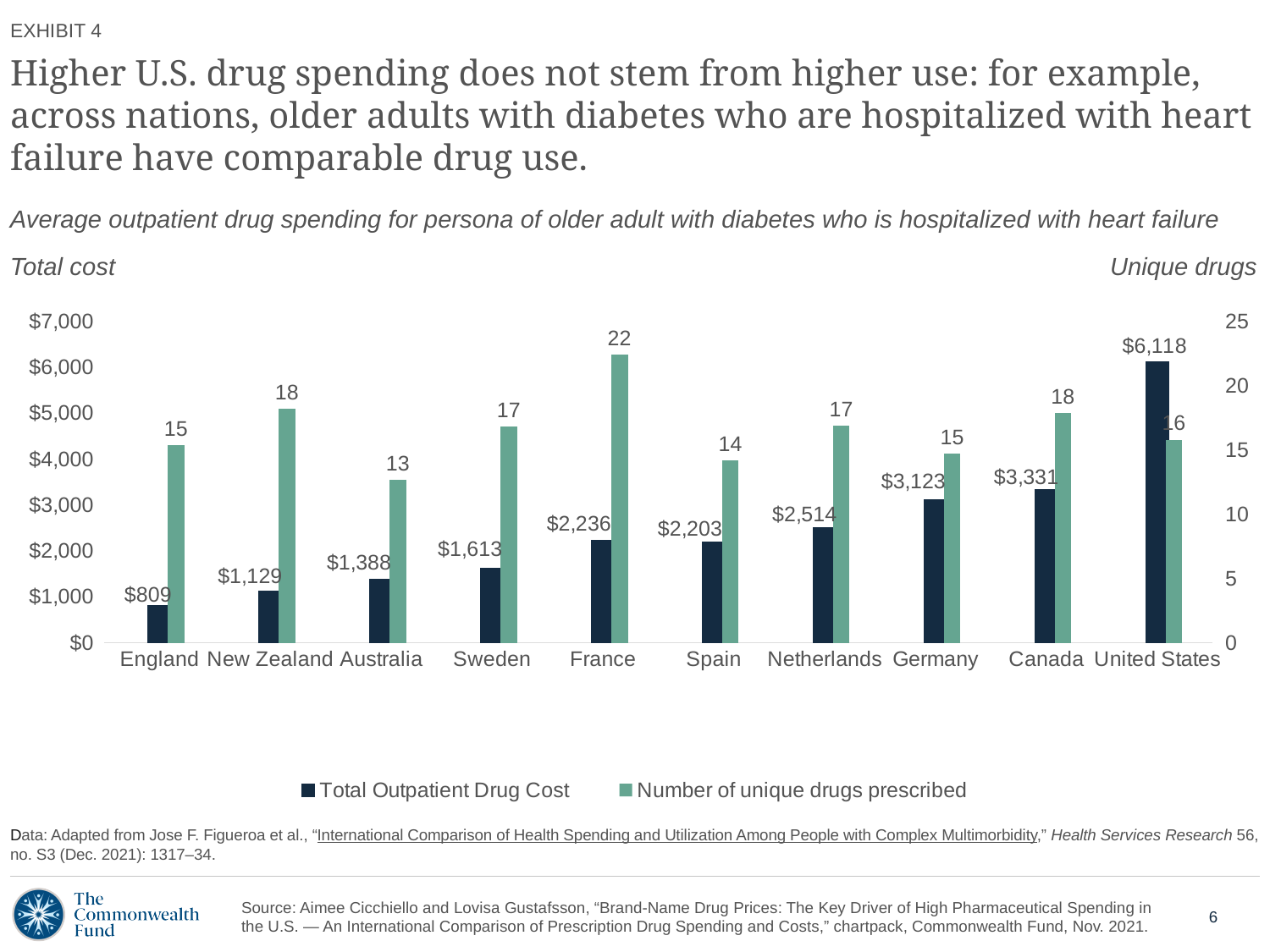
How many series does the legend list? 2 What is the label of the right-hand vertical axis? Unique drugs Which country has the lowest Total Outpatient Drug Cost? England What is the difference in Total Outpatient Drug Cost between the United States and Canada? $2,787 Which country has the highest Total Outpatient Drug Cost? United States Which country has the lowest Number of unique drugs prescribed? Australia What is the Total Outpatient Drug Cost for Germany? $3,123 What is the Total Outpatient Drug Cost for the United States? $6,118 How many countries are shown on the x axis? 10 What is the Number of unique drugs prescribed for France? 22 What kind of chart is shown on the slide? Bar chart Which has a higher Number of unique drugs prescribed, New Zealand or Spain? New Zealand